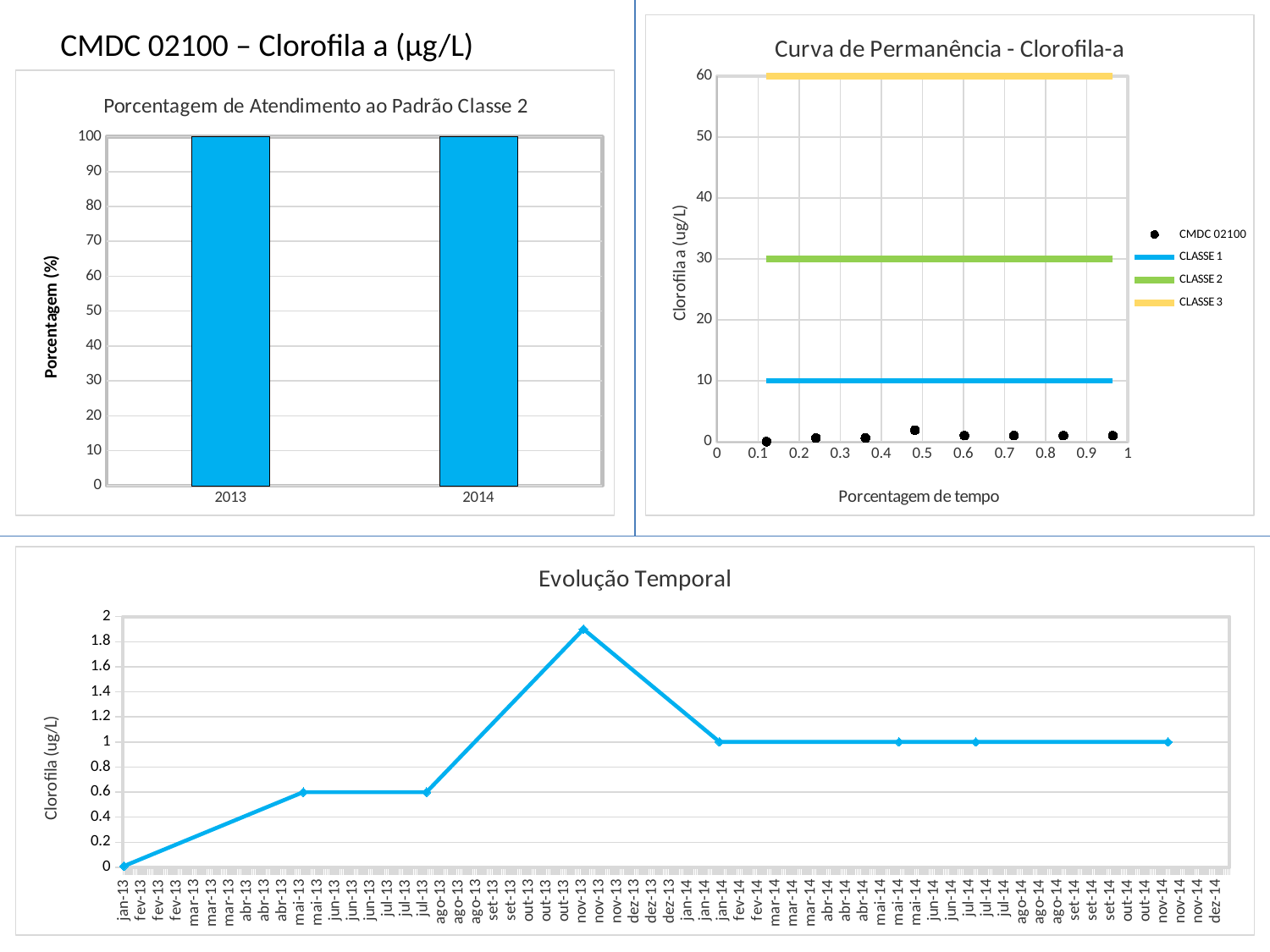
In the chart titled 'Porcentagem de Atendimento ao Padrão Classe 2', what is the value for 2013? 100 How many categories are shown on the x axis of the chart titled 'Porcentagem de Atendimento ao Padrão Classe 2'? 2 In the chart titled 'Porcentagem de Atendimento ao Padrão Classe 2', what is the value for 2014? 100 In the chart titled 'Curva de Permanência - Clorofila-a', at what Clorofila a value is the CLASSE 3 line drawn? 60 In the chart titled 'Curva de Permanência - Clorofila-a', are the CMDC 02100 points greater or less than 10? less How many series does the legend of the chart titled 'Curva de Permanência - Clorofila-a' list? 4 In the chart titled 'Evolução Temporal', which month has the highest Clorofila value? nov-13 In the chart titled 'Evolução Temporal', what is the Clorofila value for mai-13? 0.6 What kind of chart is 'Evolução Temporal'? line chart In the chart titled 'Curva de Permanência - Clorofila-a', at what Clorofila a value is the CLASSE 2 line drawn? 30 What kind of chart is 'Porcentagem de Atendimento ao Padrão Classe 2'? bar chart In the chart titled 'Evolução Temporal', is the value for nov-13 greater or less than 1.5? greater